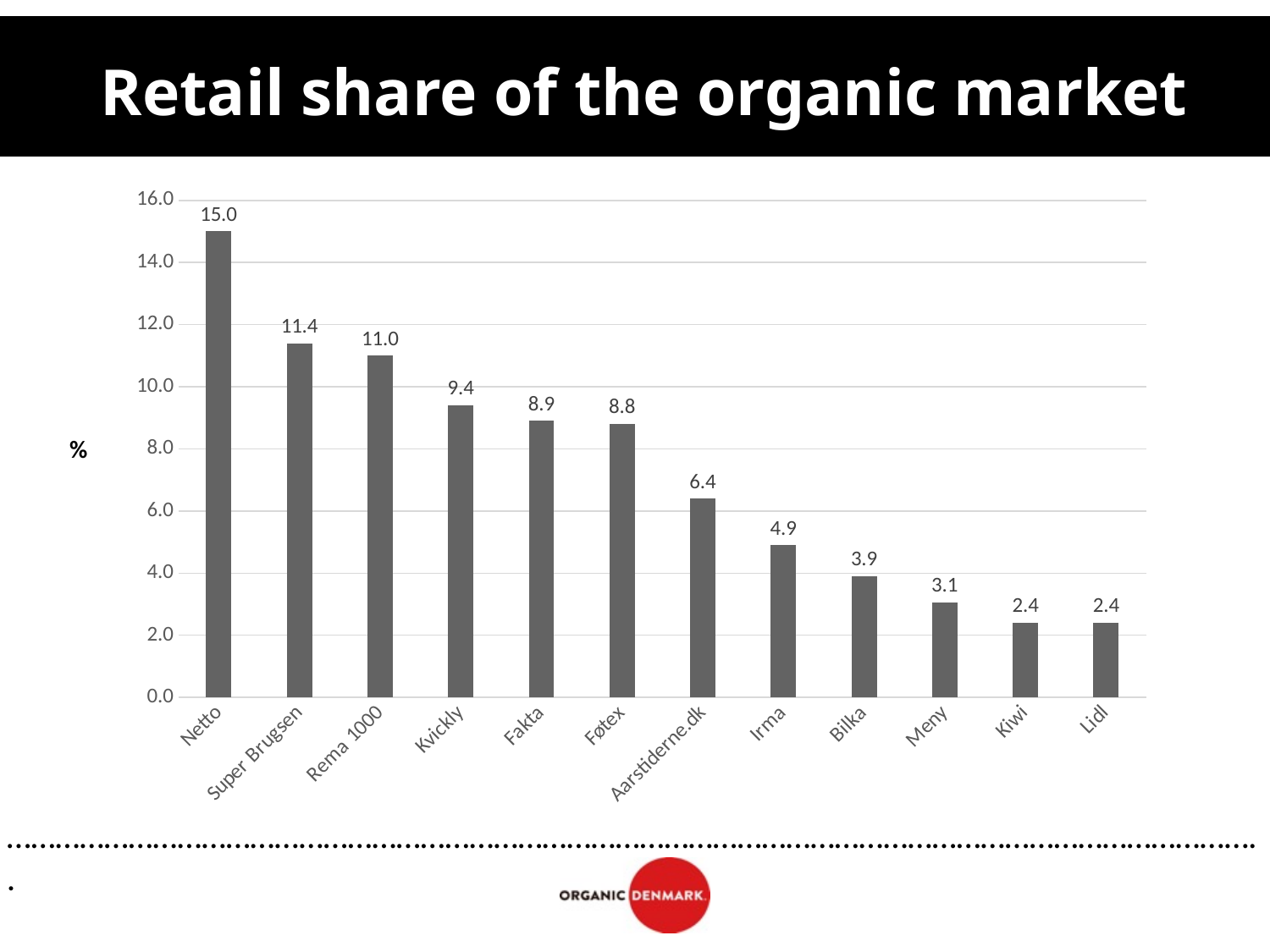
What is the value for Meny? 3.1 What is the value for Aarstiderne.dk? 6.4 Is the value for Fakta greater or less than 8.0? greater Which is larger, the value for Rema 1000 or the value for Kvickly? Rema 1000 Do the values rise or fall from left to right along the x axis? fall What kind of chart is shown on the slide? bar chart What is the title of the chart? Retail share of the organic market What is the value for Netto? 15.0 What is the difference between the values for Netto and Super Brugsen? 3.6 Which retailer has the highest share? Netto What is the difference between the values for Irma and Bilka? 1.0 How many retailers are shown on the chart? 12